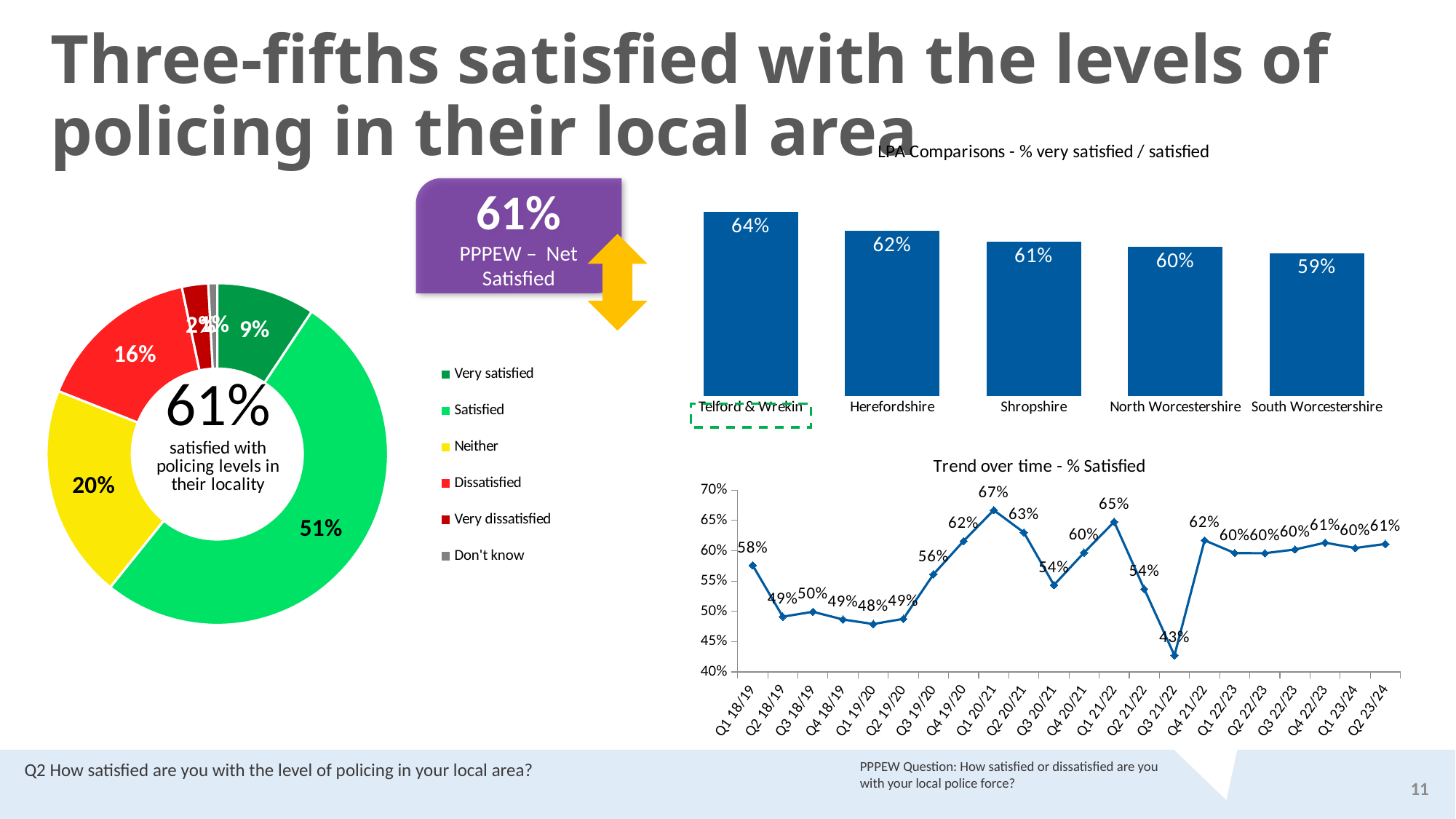
In the donut chart on the left, what share of respondents are Satisfied? 51% In the Trend over time line chart, which quarter has the lowest value? Q3 21/22 How many entries does the legend of the donut chart list? 6 In the Trend over time line chart, is the value for Q2 23/24 greater or less than 60%? greater In the Trend over time line chart, which is larger: Q4 19/20 or Q2 20/21? Q2 20/21 In the LPA Comparisons bar chart, what is the difference between Telford & Wrekin and Shropshire? 3 percentage points What kind of chart is the Trend over time chart? Line chart In the donut chart on the left, what is the value for Neither? 20% In the LPA Comparisons bar chart, what is the value for Telford & Wrekin? 64% In the Trend over time line chart, what is the value for Q1 20/21? 67% In the LPA Comparisons bar chart, which area has the lowest value? South Worcestershire How many areas are shown in the LPA Comparisons bar chart? 5